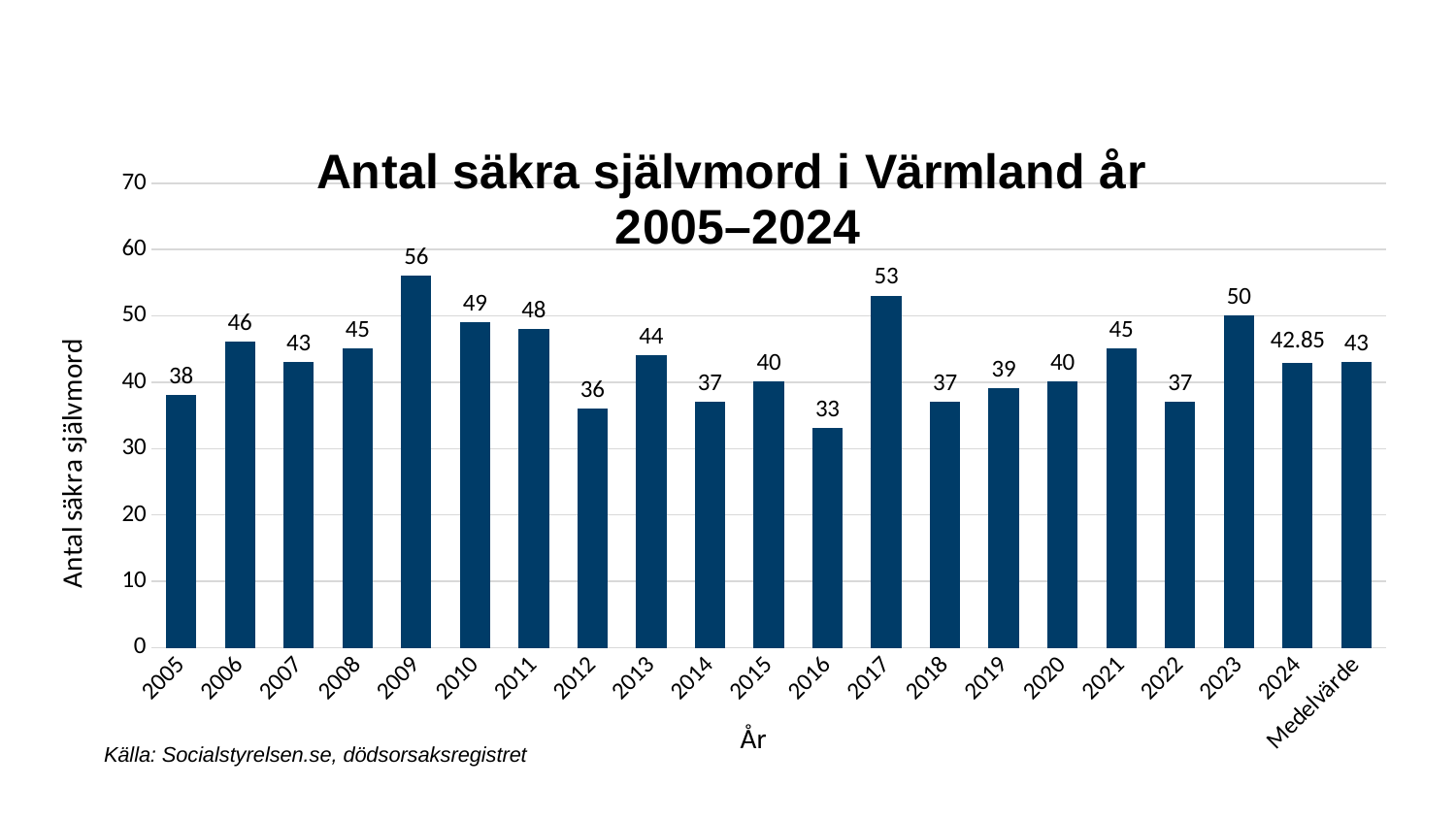
What is the title of the chart? Antal säkra självmord i Värmland år 2005–2024 What kind of chart is this? bar chart What is the difference between the values for 2017 and 2018? 16 Which is larger, the value for 2010 or the value for 2011? 2010 Which year has the lowest value? 2016 How many bars are shown in the chart? 21 Is the value for 2023 greater or less than 40? greater What is the label of the y axis? Antal säkra självmord What is the value for 2016? 33 What is the value shown for Medelvärde? 43 What is the value for 2009? 56 Which year has the highest value? 2009